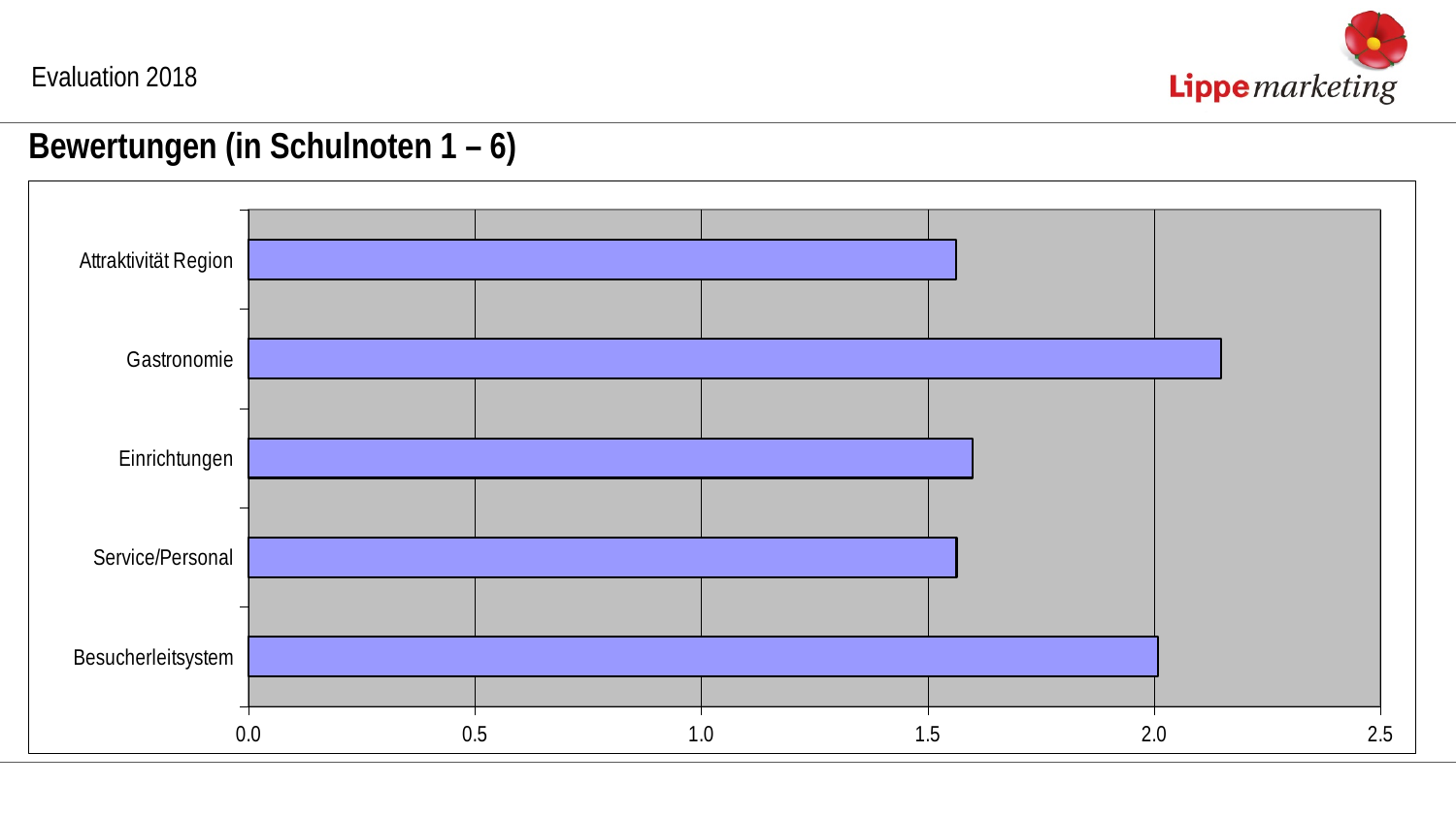
Is the value for Gastronomie greater or less than 2.0? greater Which category has the highest value in the chart? Gastronomie Is the value for Service/Personal greater or less than 2.0? less Is the value for Attraktivität Region greater or less than 1.5? greater What is the title of the chart on the slide? Bewertungen (in Schulnoten 1 – 6) What is the highest value shown on the chart's horizontal axis? 2.5 Which is larger, the value for Besucherleitsystem or the value for Service/Personal? Besucherleitsystem Which is larger, the value for Gastronomie or the value for Einrichtungen? Gastronomie How many categories are plotted in the chart? 5 What kind of chart is shown on the slide? bar chart